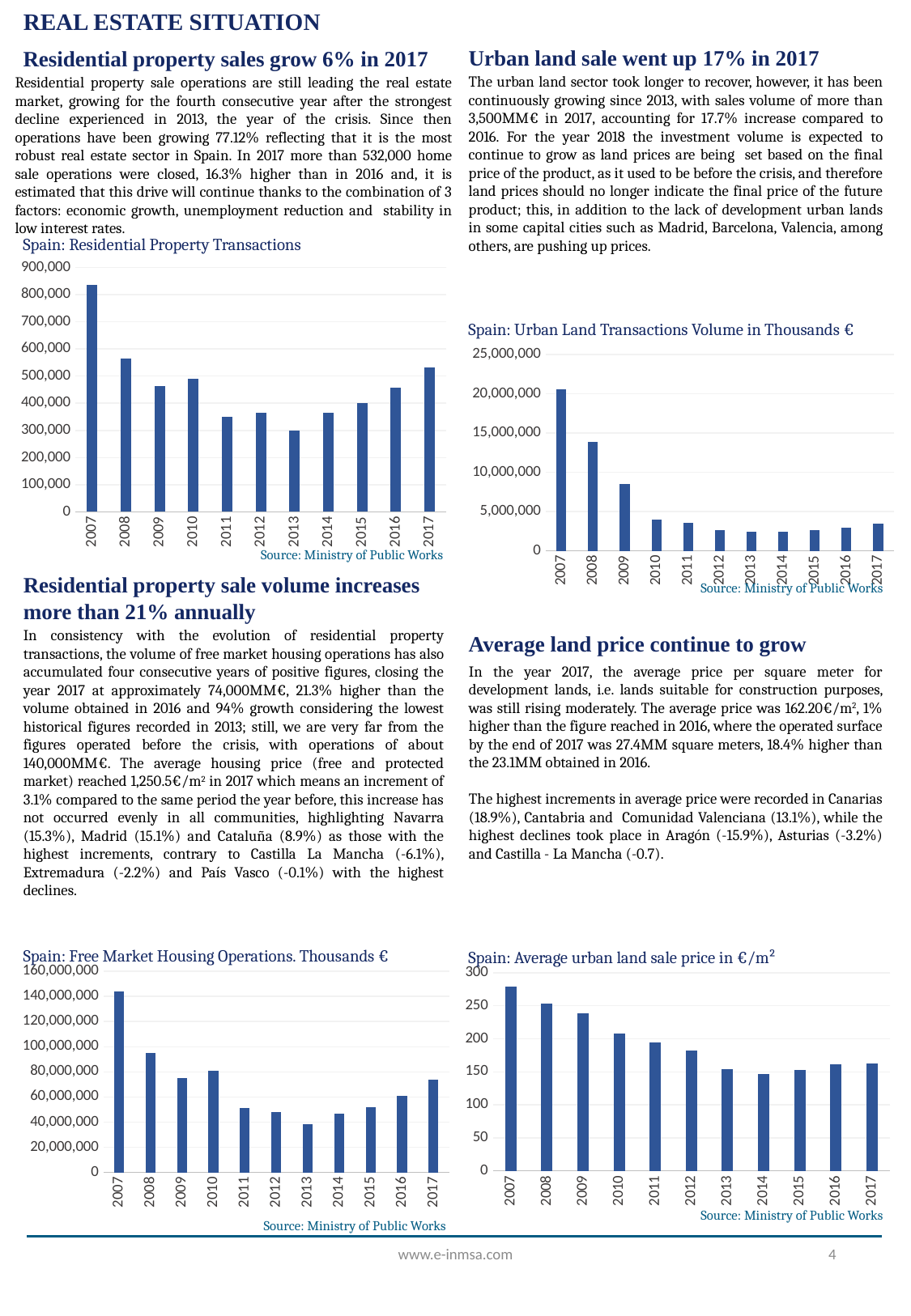
What kind of chart is 'Spain: Average urban land sale price in €/m²'? bar chart In the chart titled 'Spain: Urban Land Transactions Volume in Thousands €', which year has the highest value? 2007 How many years are shown on the x axis of the chart titled 'Spain: Average urban land sale price in €/m²'? 11 In the chart titled 'Spain: Urban Land Transactions Volume in Thousands €', is the value for 2008 greater or less than 10,000,000? greater In the chart titled 'Spain: Residential Property Transactions', is the value for 2017 greater or less than 500,000? greater In the chart titled 'Spain: Free Market Housing Operations. Thousands €', which year has the lowest value? 2013 In the chart titled 'Spain: Residential Property Transactions', which year has the lowest value? 2013 In the chart titled 'Spain: Average urban land sale price in €/m²', is the value for 2007 greater or less than 250? greater In the chart titled 'Spain: Residential Property Transactions', which is larger, the value for 2008 or the value for 2010? 2008 In the chart titled 'Spain: Residential Property Transactions', which year has the highest value? 2007 In the chart titled 'Spain: Urban Land Transactions Volume in Thousands €', do the values rise or fall from 2007 to 2013? fall